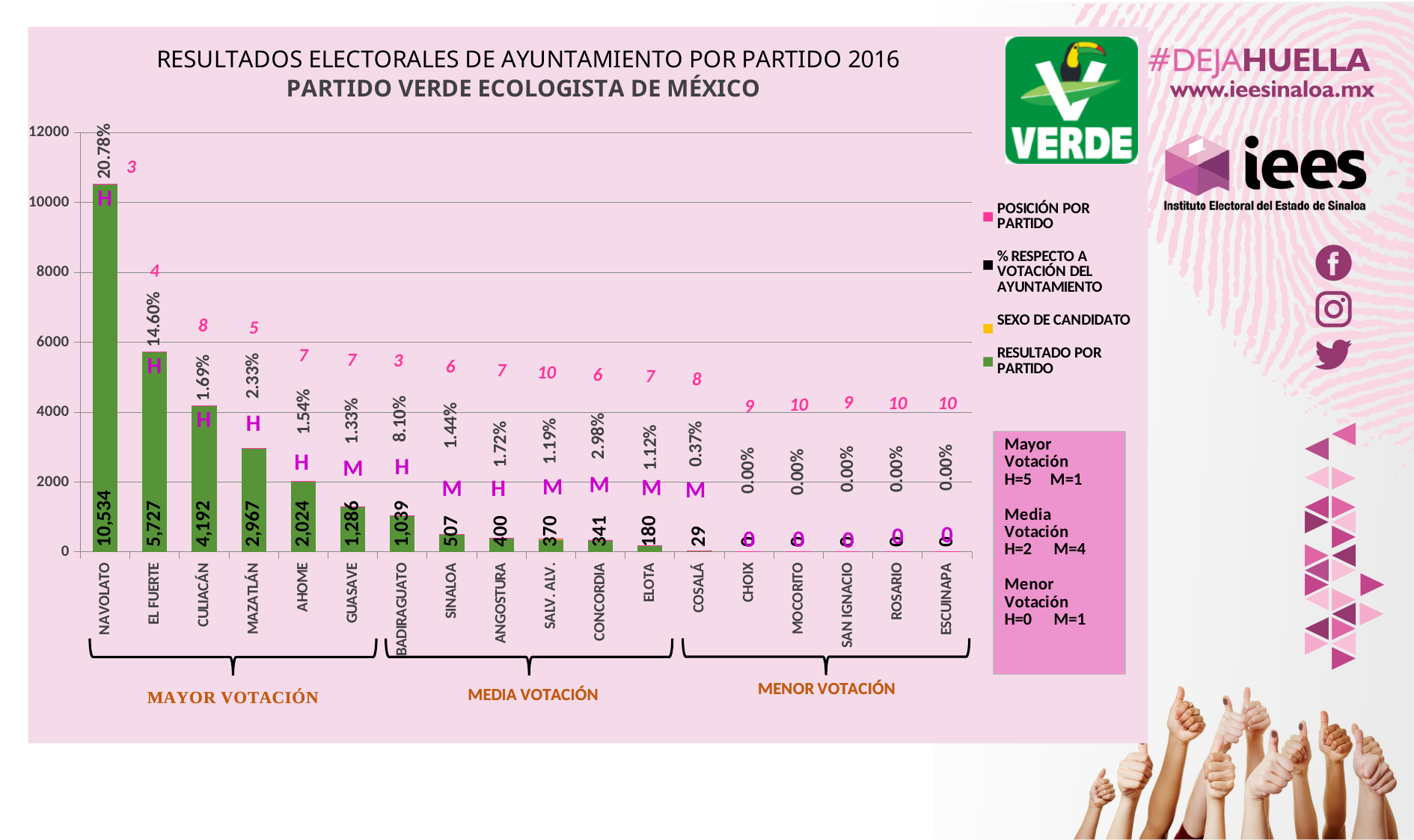
What kind of chart is shown on the slide? bar chart What is the POSICIÓN POR PARTIDO value shown for CULIACÁN? 8 How many series does the legend list? 4 Which has a larger RESULTADO POR PARTIDO, MAZATLÁN or AHOME? MAZATLÁN What percentage (% RESPECTO A VOTACIÓN DEL AYUNTAMIENTO) is shown for BADIRAGUATO? 8.10% Which municipality has the highest RESULTADO POR PARTIDO? NAVOLATO Is the RESULTADO POR PARTIDO bar for CULIACÁN greater or less than 4000? greater How many municipalities are shown on the x axis? 18 What is the RESULTADO POR PARTIDO value for EL FUERTE? 5,727 Do the RESULTADO POR PARTIDO values rise or fall from left to right along the x axis? fall What is the RESULTADO POR PARTIDO value for NAVOLATO? 10,534 What is the difference between the RESULTADO POR PARTIDO values for NAVOLATO and EL FUERTE? 4,807